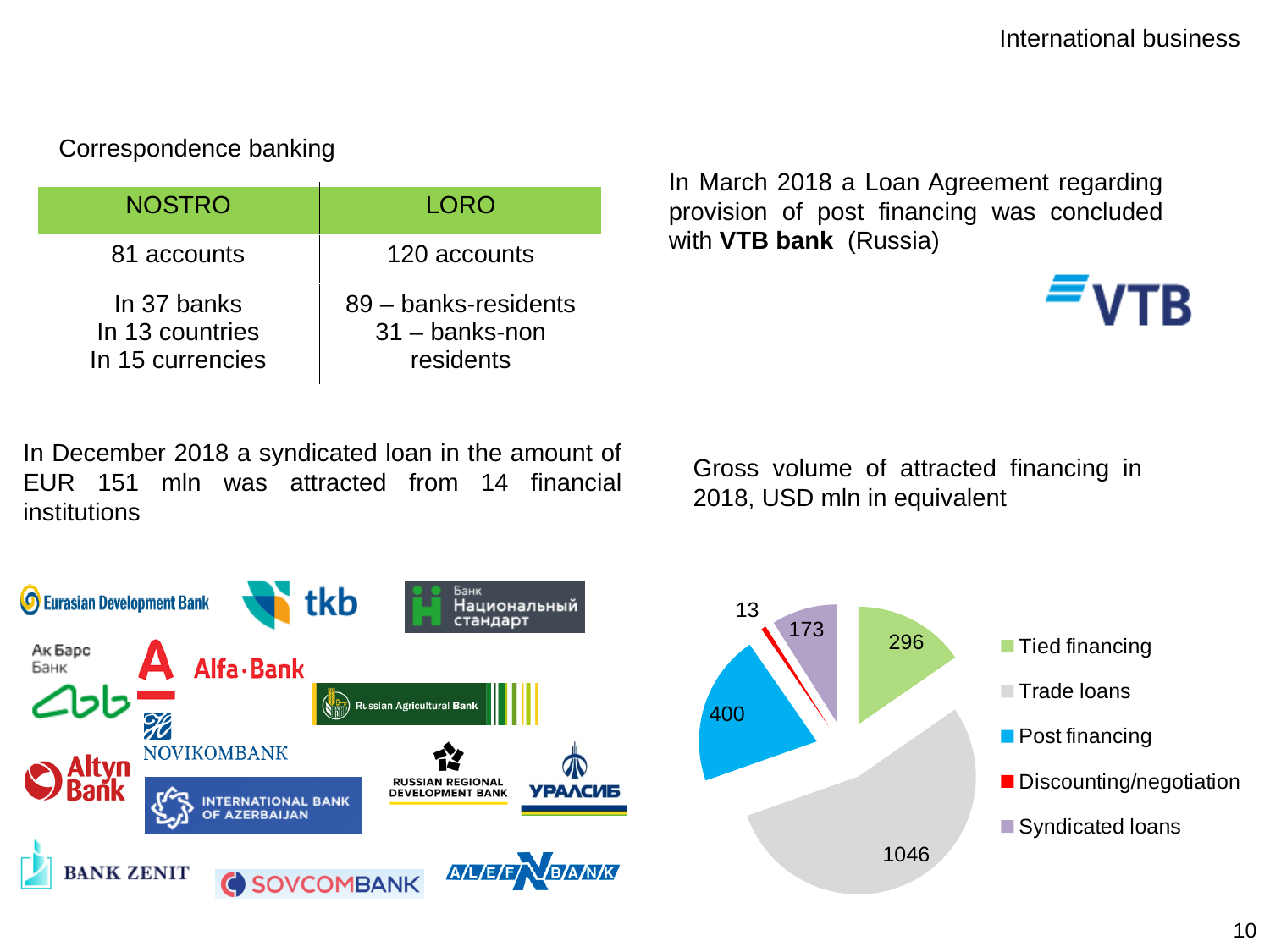
What is the value for Discounting/negotiation in the pie chart? 13 What is the value for Tied financing in the pie chart? 296 How many categories does the pie chart show? 5 What type of chart is shown on the slide? Pie chart What is the value for Trade loans in the pie chart? 1046 Which is larger, Syndicated loans or Tied financing? Tied financing Which category has the largest slice in the pie chart? Trade loans What is the title of the pie chart? Gross volume of attracted financing in 2018, USD mln in equivalent What is the difference between the values for Post financing and Tied financing? 104 Which category has the smallest slice in the pie chart? Discounting/negotiation What is the value for Syndicated loans in the pie chart? 173 What is the value for Post financing in the pie chart? 400